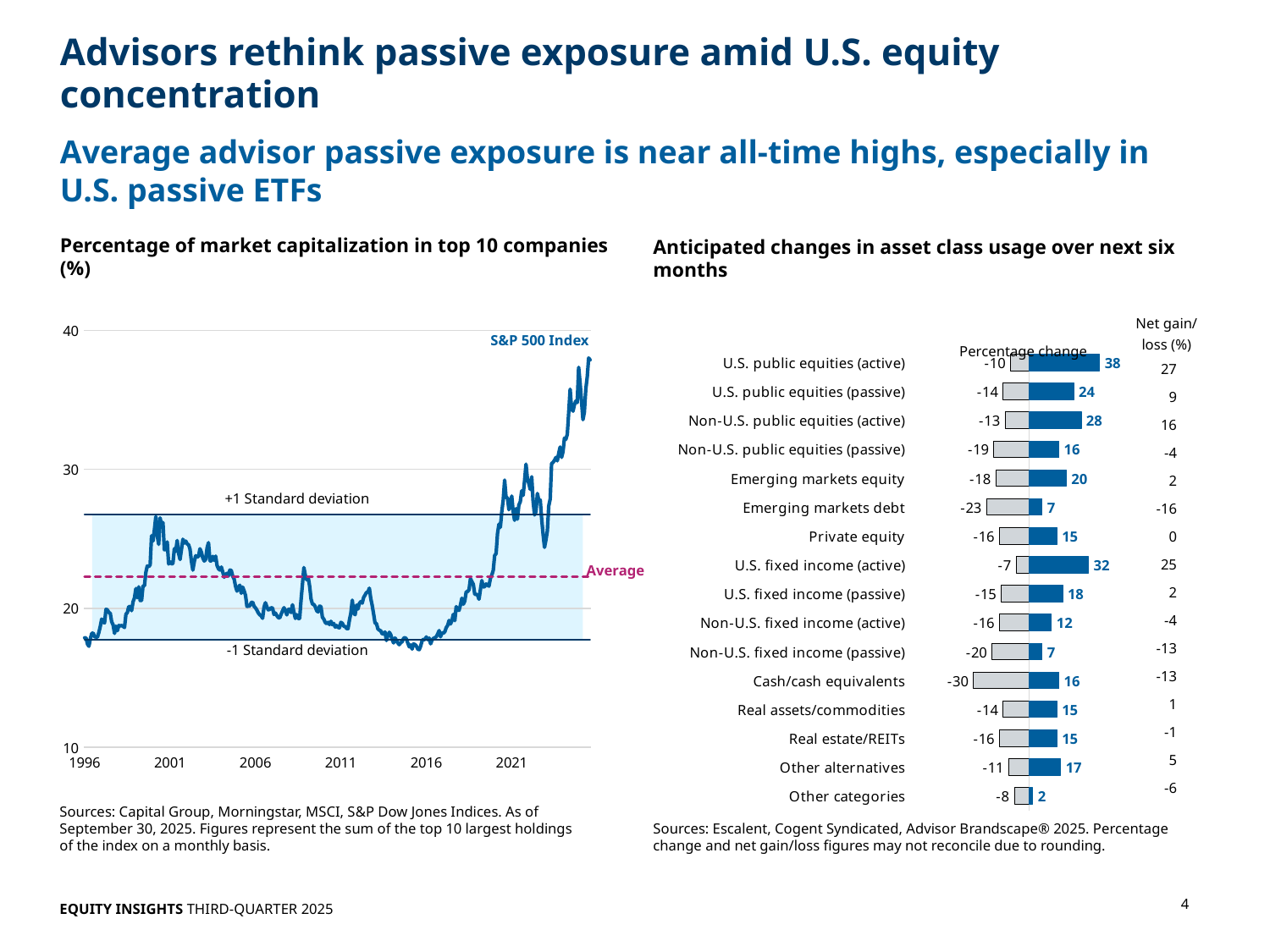
In the left chart, is the value of the S&P 500 Index line at its most recent point greater or less than 30? greater How many asset classes are listed in the right chart? 16 In the right chart, what is the negative percentage change for Cash/cash equivalents? -30 In the right chart, what is the difference between the positive percentage change for U.S. public equities (active) and U.S. public equities (passive)? 14 What type of chart is the left chart, 'Percentage of market capitalization in top 10 companies (%)'? line chart In the left chart, does the S&P 500 Index line rise or fall from 2016 to the end of the series? rise In the right chart, what is the positive percentage change for U.S. public equities (active)? 38 In the right chart, which asset class has the lowest positive percentage change? Other categories In the right chart, which has a larger positive percentage change: Emerging markets equity or Private equity? Emerging markets equity In the right chart, which asset class has the highest positive percentage change? U.S. public equities (active) What type of chart is the right chart, 'Anticipated changes in asset class usage over next six months'? bar chart In the right chart, what is the net gain/loss (%) for U.S. fixed income (active)? 25